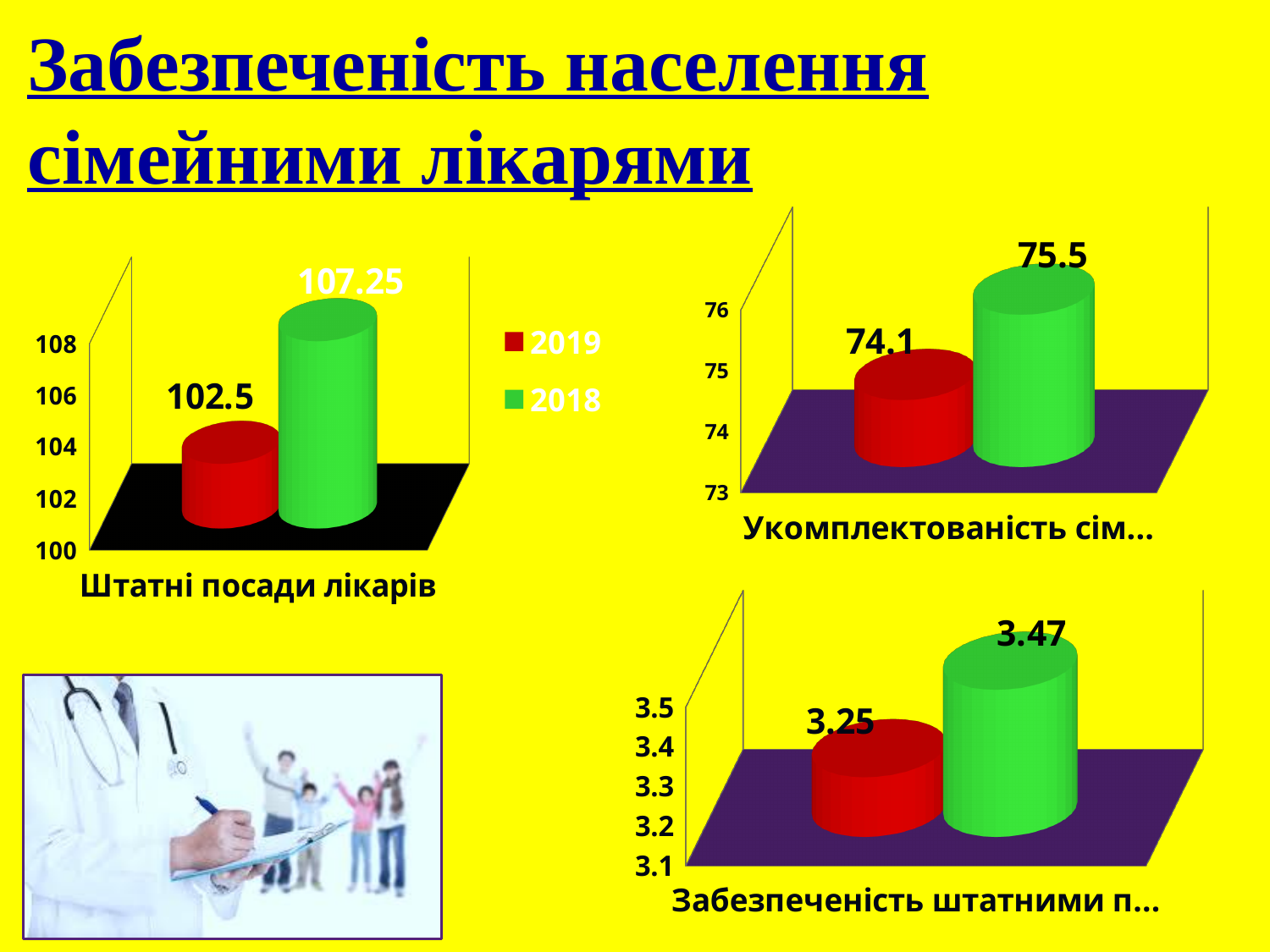
How many series does the legend of the chart titled 'Штатні посади лікарів' list? 2 In the chart titled 'Штатні посади лікарів', which year has the higher value, 2019 or 2018? 2018 In the bottom-right chart (title beginning 'Забезпеченість штатними'), what is the value of the red bar? 3.25 In the top-right chart (title beginning 'Укомплектованість'), what is the difference between the green bar and the red bar? 1.4 In the chart titled 'Штатні посади лікарів', what is the value for 2019? 102.5 In the top-right chart (title beginning 'Укомплектованість'), what is the value of the red bar? 74.1 In the chart titled 'Штатні посади лікарів', what is the difference between the 2018 and 2019 values? 4.75 What type of chart is the chart titled 'Штатні посади лікарів'? bar chart In the chart titled 'Штатні посади лікарів', what is the value for 2018? 107.25 In the bottom-right chart (title beginning 'Забезпеченість штатними'), what is the value of the green bar? 3.47 In the top-right chart (title beginning 'Укомплектованість'), what is the value of the green bar? 75.5 In the bottom-right chart (title beginning 'Забезпеченість штатними'), which bar is taller, the red one or the green one? the green one